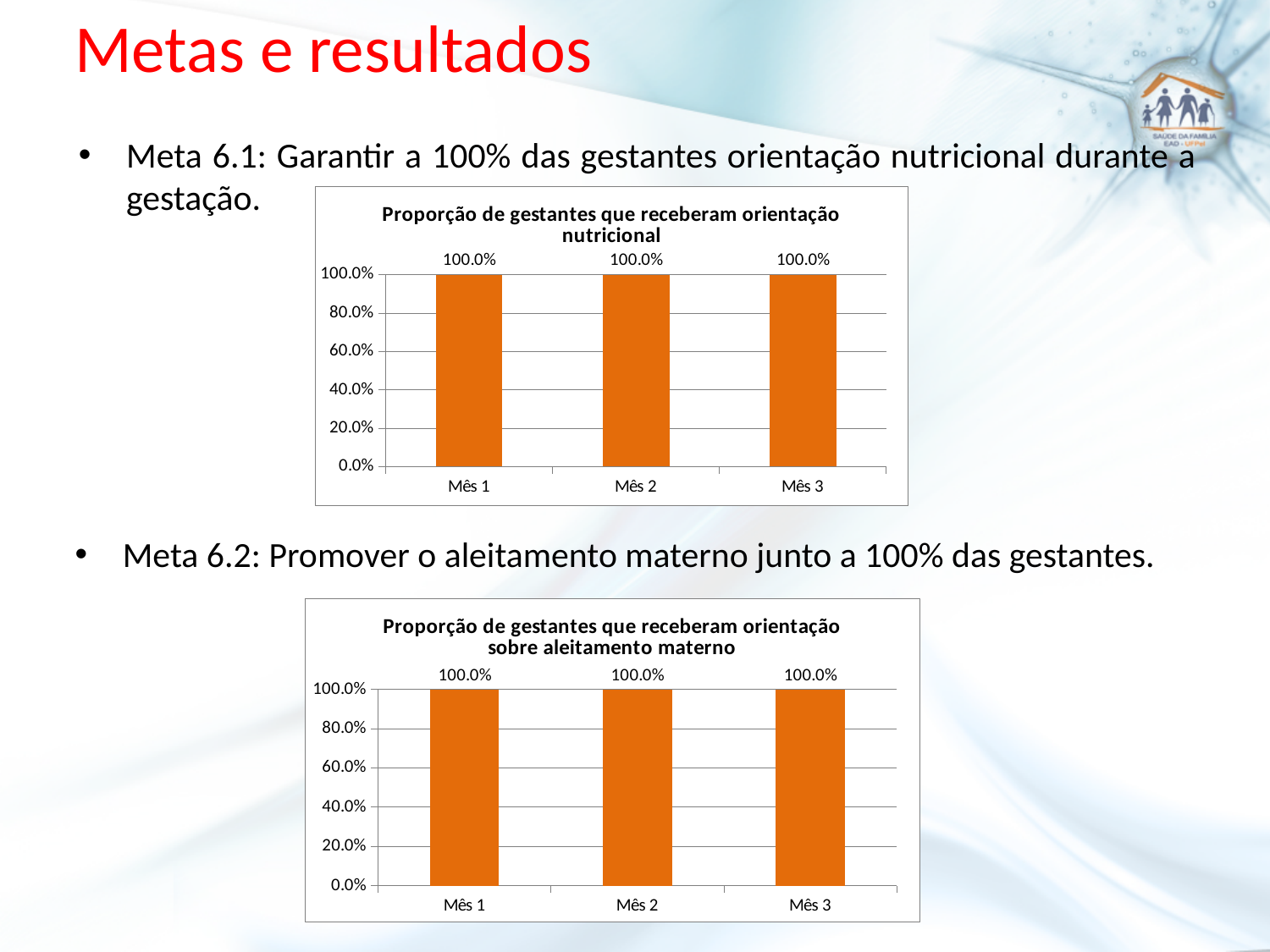
How many categories are shown on the x axis of the top chart (Proporção de gestantes que receberam orientação nutricional)? 3 In the top chart (Proporção de gestantes que receberam orientação nutricional), what is the value for Mês 3? 100.0% Do the values in the bottom chart (Proporção de gestantes que receberam orientação sobre aleitamento materno) rise, fall, or stay the same from Mês 1 to Mês 3? Stay the same In the bottom chart (Proporção de gestantes que receberam orientação sobre aleitamento materno), what is the difference between the values for Mês 2 and Mês 1? 0.0% In the top chart (Proporção de gestantes que receberam orientação nutricional), what is the value for Mês 1? 100.0% In the top chart (Proporção de gestantes que receberam orientação nutricional), what is the difference between the values for Mês 1 and Mês 3? 0.0% What colour are the bars in the top chart (Proporção de gestantes que receberam orientação nutricional)? Orange What kind of chart is the top chart (Proporção de gestantes que receberam orientação nutricional)? Bar chart What is the title of the bottom chart on the slide? Proporção de gestantes que receberam orientação sobre aleitamento materno In the bottom chart (Proporção de gestantes que receberam orientação sobre aleitamento materno), what is the value for Mês 3? 100.0% In the bottom chart (Proporção de gestantes que receberam orientação sobre aleitamento materno), what is the value for Mês 2? 100.0% How many bars are plotted in the bottom chart (Proporção de gestantes que receberam orientação sobre aleitamento materno)? 3